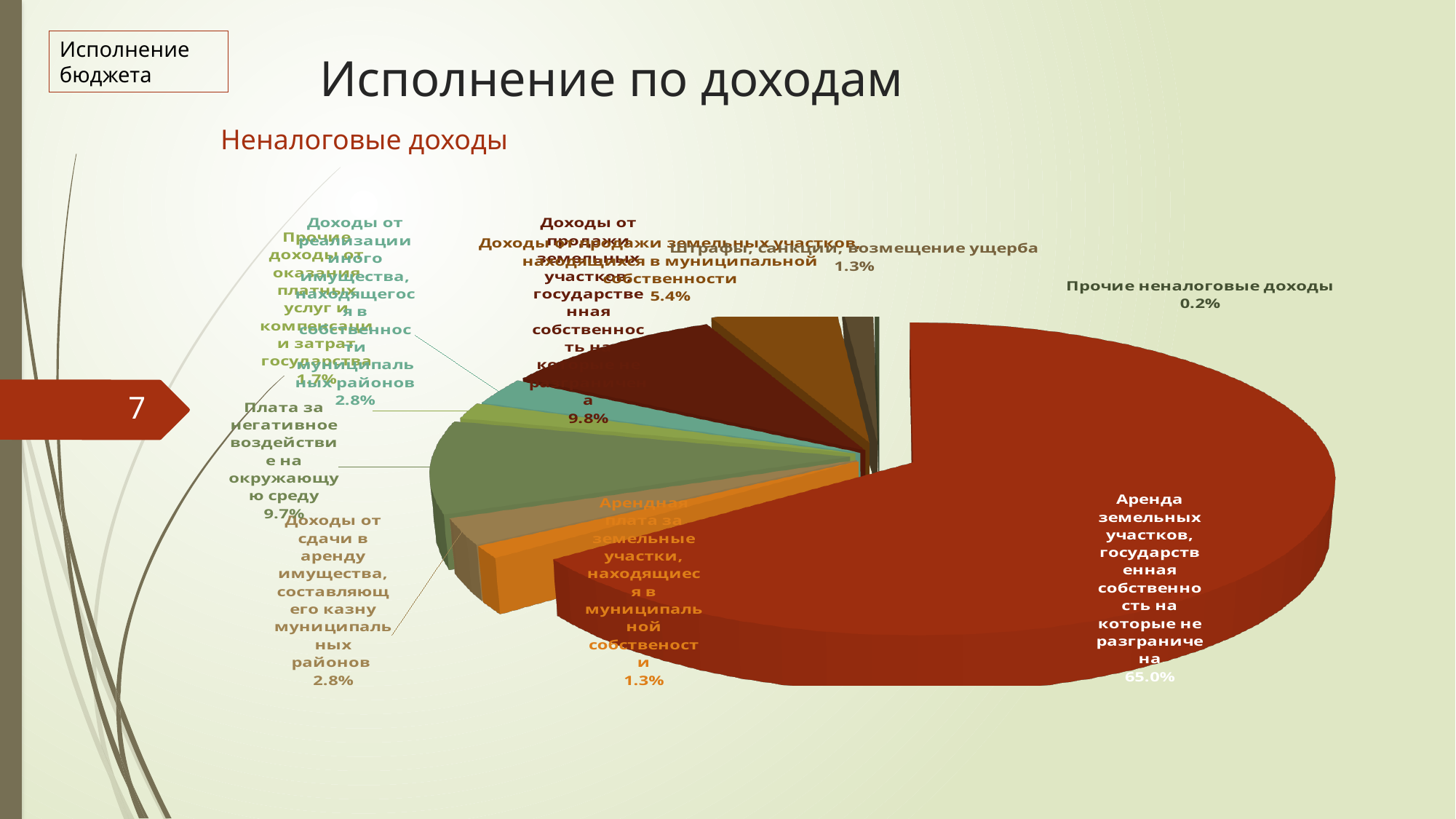
What share of the pie is 'Аренда земельных участков, государственная собственность на которые не разграничена'? 65.0% What is the difference between the share of 'Доходы от продажи земельных участков, государственная собственность на которые не разграничена' (9.8%) and 'Доходы от продажи земельных участков, находящихся в муниципальной собственности' (5.4%)? 4.4% Which category has the largest share of the pie? Аренда земельных участков, государственная собственность на которые не разграничена What share of the pie is 'Штрафы, санкции, возмещение ущерба'? 1.3% What is the title of the chart? Неналоговые доходы What kind of chart is shown on the slide? pie chart What share of the pie is 'Прочие неналоговые доходы'? 0.2% Which category has the smallest share of the pie? Прочие неналоговые доходы What share of the pie is 'Доходы от продажи земельных участков, находящихся в муниципальной собственности'? 5.4% Which is larger: the share of 'Плата за негативное воздействие на окружающую среду' or the share of 'Доходы от сдачи в аренду имущества, составляющего казну муниципальных районов'? Плата за негативное воздействие на окружающую среду What share of the pie is 'Плата за негативное воздействие на окружающую среду'? 9.7% How many categories (slices) does the pie chart have? 10